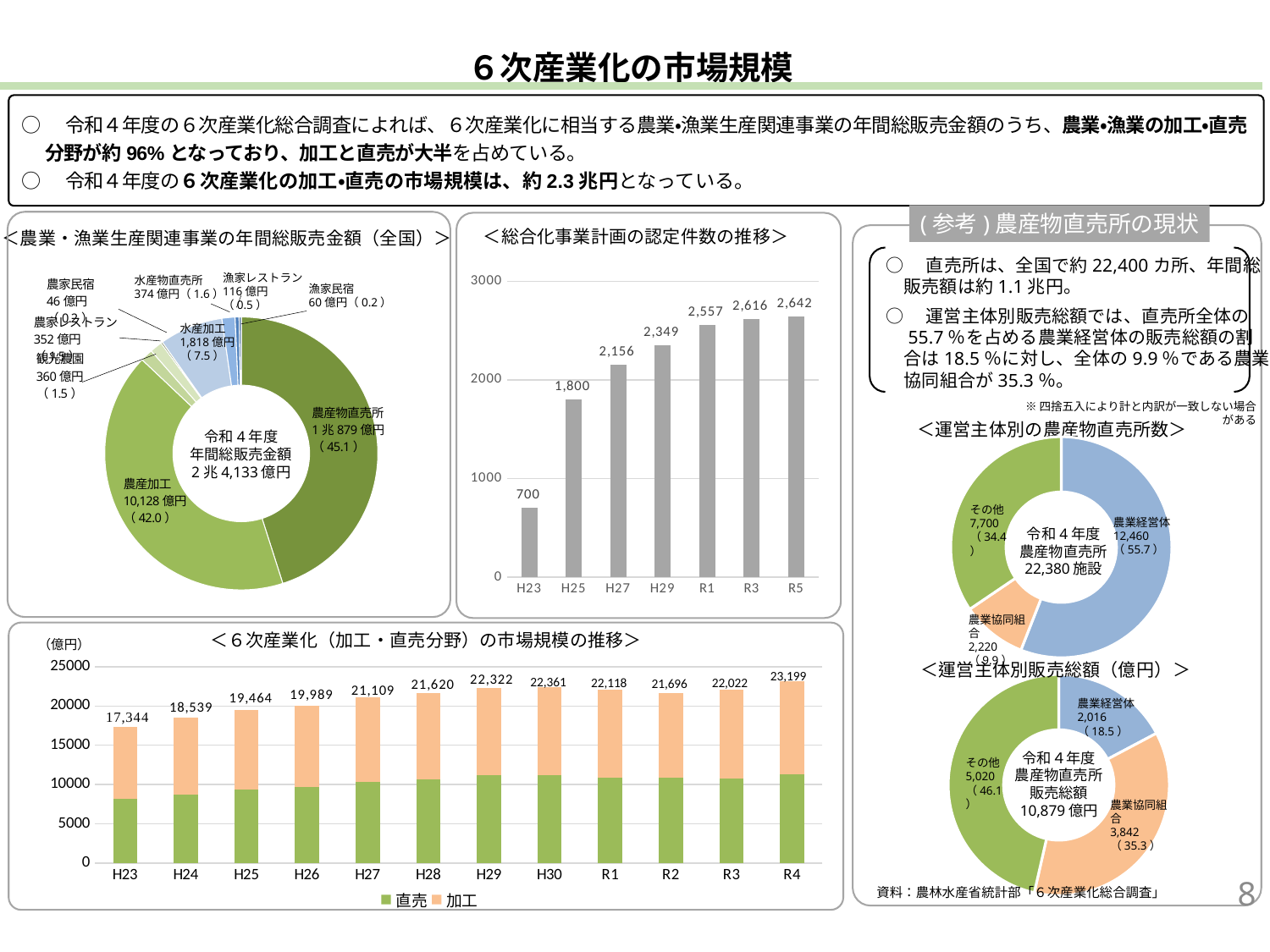
In the chart titled 6次産業化（加工・直売分野）の市場規模の推移, which year has the lowest total? H23 In the chart titled 6次産業化（加工・直売分野）の市場規模の推移, what is the total value labelled for R4? 23,199 In the chart titled 総合化事業計画の認定件数の推移, how many years are shown on the x axis? 7 In the chart titled 6次産業化（加工・直売分野）の市場規模の推移, how many series does the legend list? 2 In the chart titled 運営主体別の農産物直売所数, what is the value for 農業経営体? 12,460 In the chart titled 6次産業化（加工・直売分野）の市場規模の推移, is the 直売 portion for H23 greater or less than 10000? less In the chart titled 総合化事業計画の認定件数の推移, do the values rise or fall from H23 to R5? rise In the chart titled 総合化事業計画の認定件数の推移, what is the difference between the values for R5 and H25? 842 In the chart titled 総合化事業計画の認定件数の推移, which year has the highest value? R5 In the chart titled 総合化事業計画の認定件数の推移, what is the value for H23? 700 In the chart titled 農業・漁業生産関連事業の年間総販売金額（全国）, what share of the total is 農産加工? 42.0 In the chart titled 運営主体別販売総額（億円）, which is larger, 農業協同組合 or 農業経営体? 農業協同組合